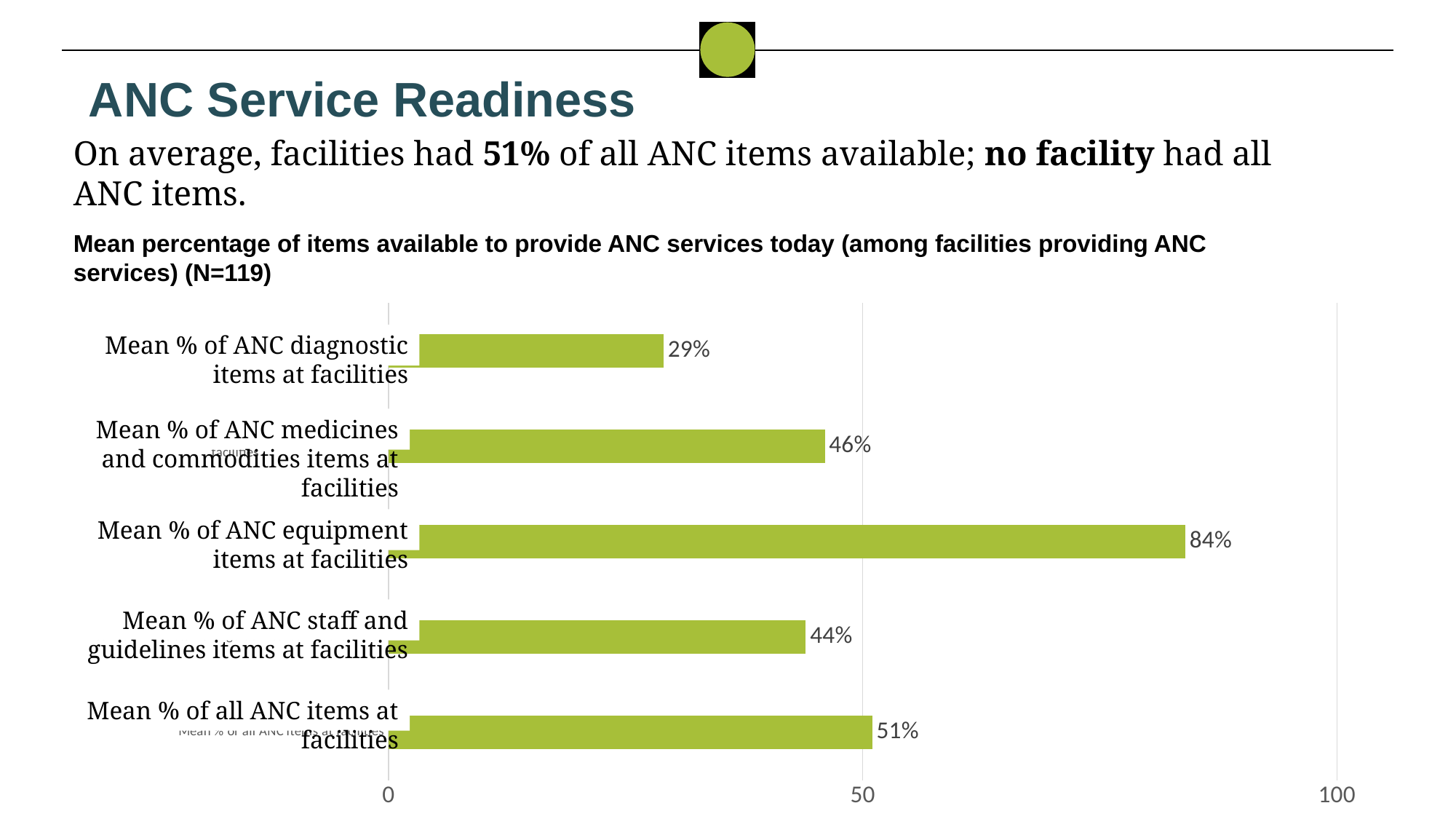
What is the mean % of ANC staff and guidelines items at facilities? 44% What is the mean % of ANC equipment items at facilities? 84% Which is larger: the mean % of ANC medicines and commodities items or the mean % of ANC staff and guidelines items? Mean % of ANC medicines and commodities items at facilities Which category has the lowest mean percentage? Mean % of ANC diagnostic items at facilities What is the mean % of all ANC items at facilities? 51% What is the mean % of ANC diagnostic items at facilities? 29% What is the mean % of ANC medicines and commodities items at facilities? 46% Which category has the highest mean percentage? Mean % of ANC equipment items at facilities How many categories are shown in the chart? 5 What is the difference between the mean % of ANC equipment items and the mean % of ANC diagnostic items? 55% What kind of chart is shown on the slide? Bar chart Is the mean % of ANC equipment items at facilities greater or less than 50? greater